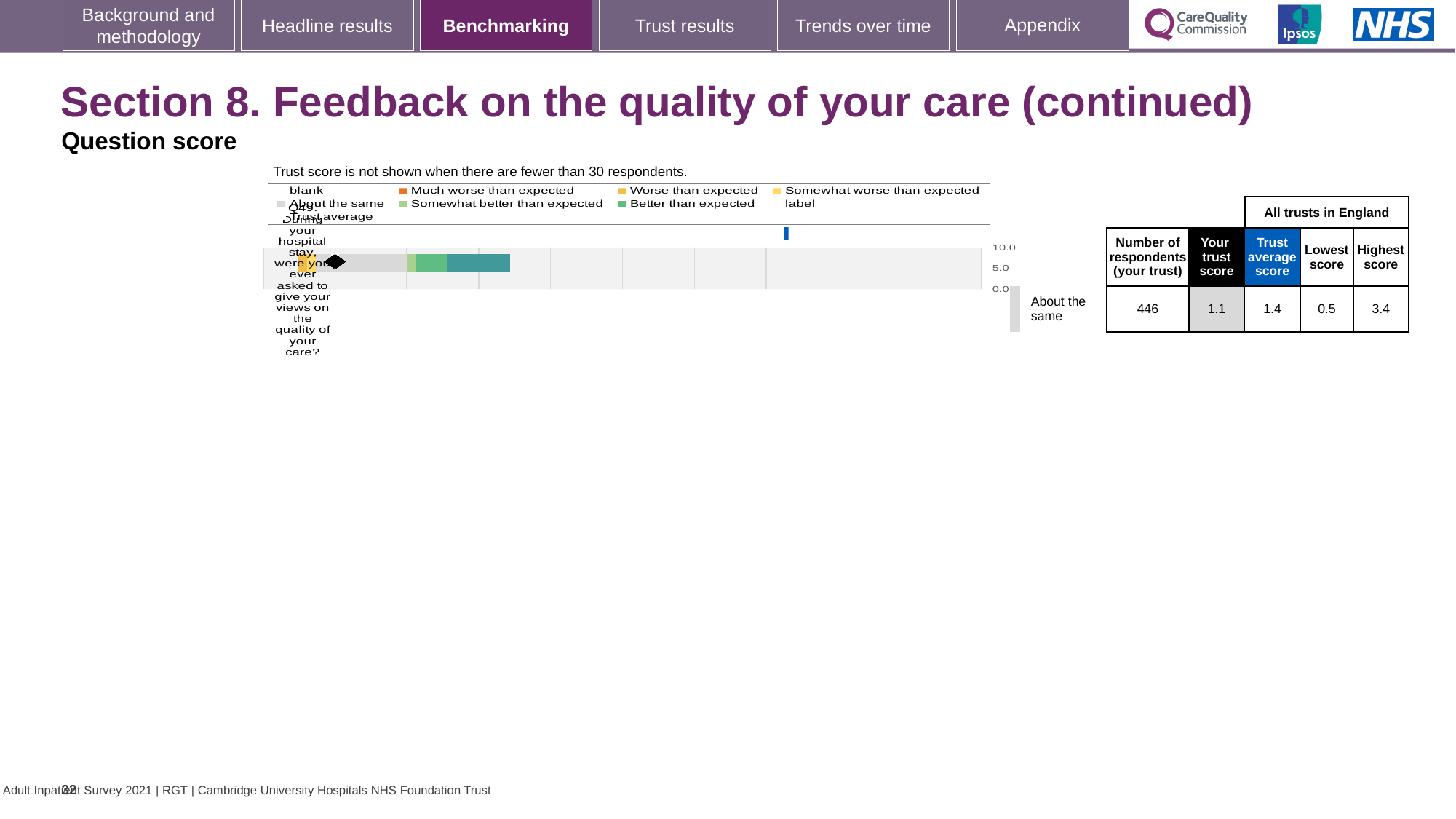
How many questions (categories) are plotted in the chart? 1 What is the difference between the highest and lowest scores for Q49? 2.9 What kind of chart is shown on the slide? bar chart Which benchmark category is the trust's Q49 result placed in? About the same What is the highest score across all trusts in England for Q49? 3.4 How many respondents from the trust answered Q49? 446 What is the trust score for Q49 shown next to the chart? 1.1 Which is larger for Q49: the trust score or the trust average score? Trust average score What is the lowest score across all trusts in England for Q49? 0.5 Below how many respondents is the trust score not shown, according to the note above the chart? 30 What is the difference between the trust average score and the trust score for Q49? 0.3 What is the trust average score for Q49 shown next to the chart? 1.4